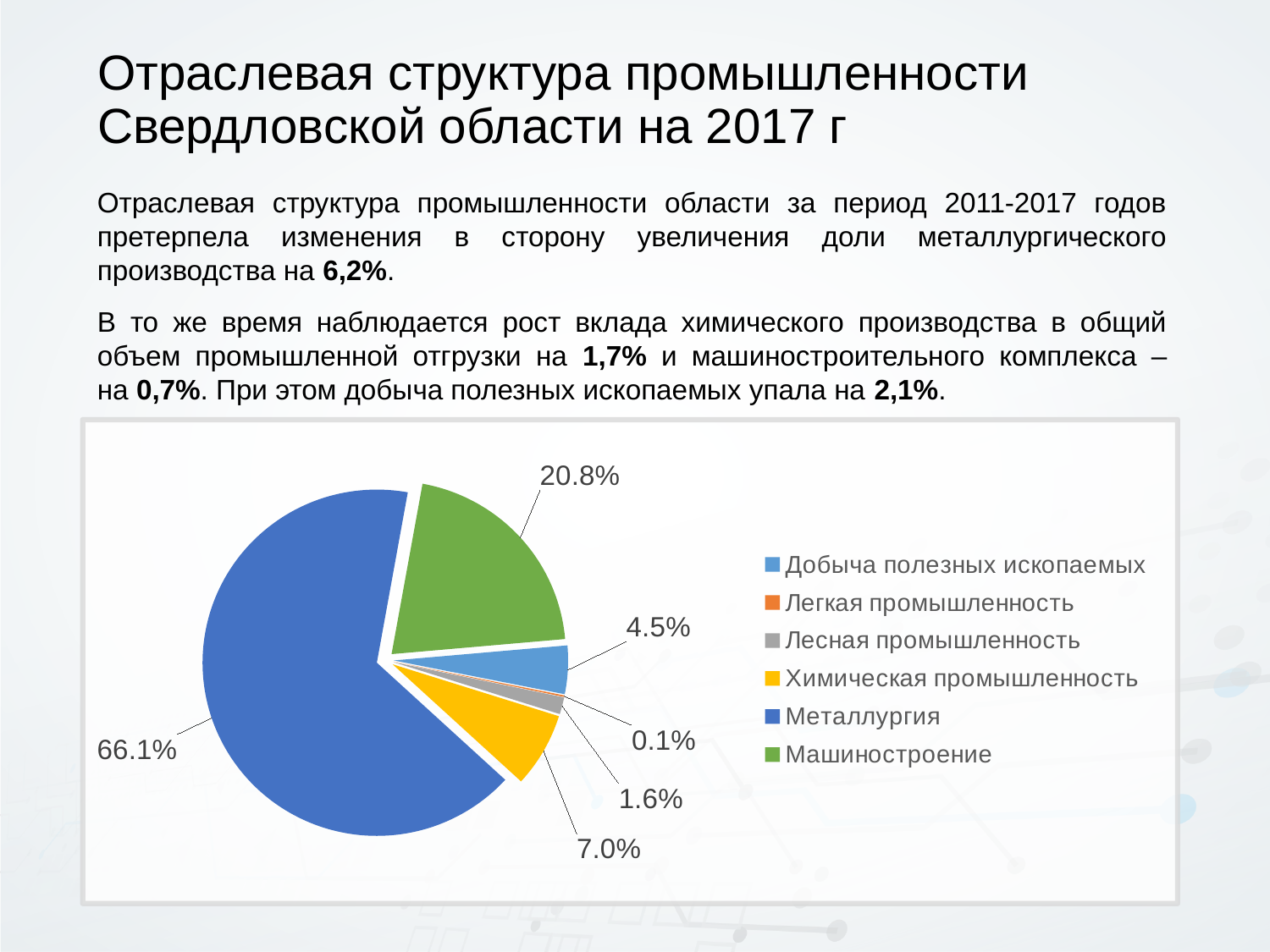
Which is larger, the share of Химическая промышленность or the share of Добыча полезных ископаемых? Химическая промышленность What share of the pie does Металлургия have? 66.1% What type of chart is shown on the slide? Pie chart What is the value shown for Химическая промышленность? 7.0% What is the value shown for Добыча полезных ископаемых? 4.5% Which category has the largest slice of the pie? Металлургия What is the difference between the shares of Металлургия and Машиностроение? 45.3% How many categories are shown in the pie chart? 6 What is the value shown for Легкая промышленность? 0.1% Which category has the smallest slice of the pie? Легкая промышленность What colour is the slice for Машиностроение? Green What share of the pie does Машиностроение have? 20.8%